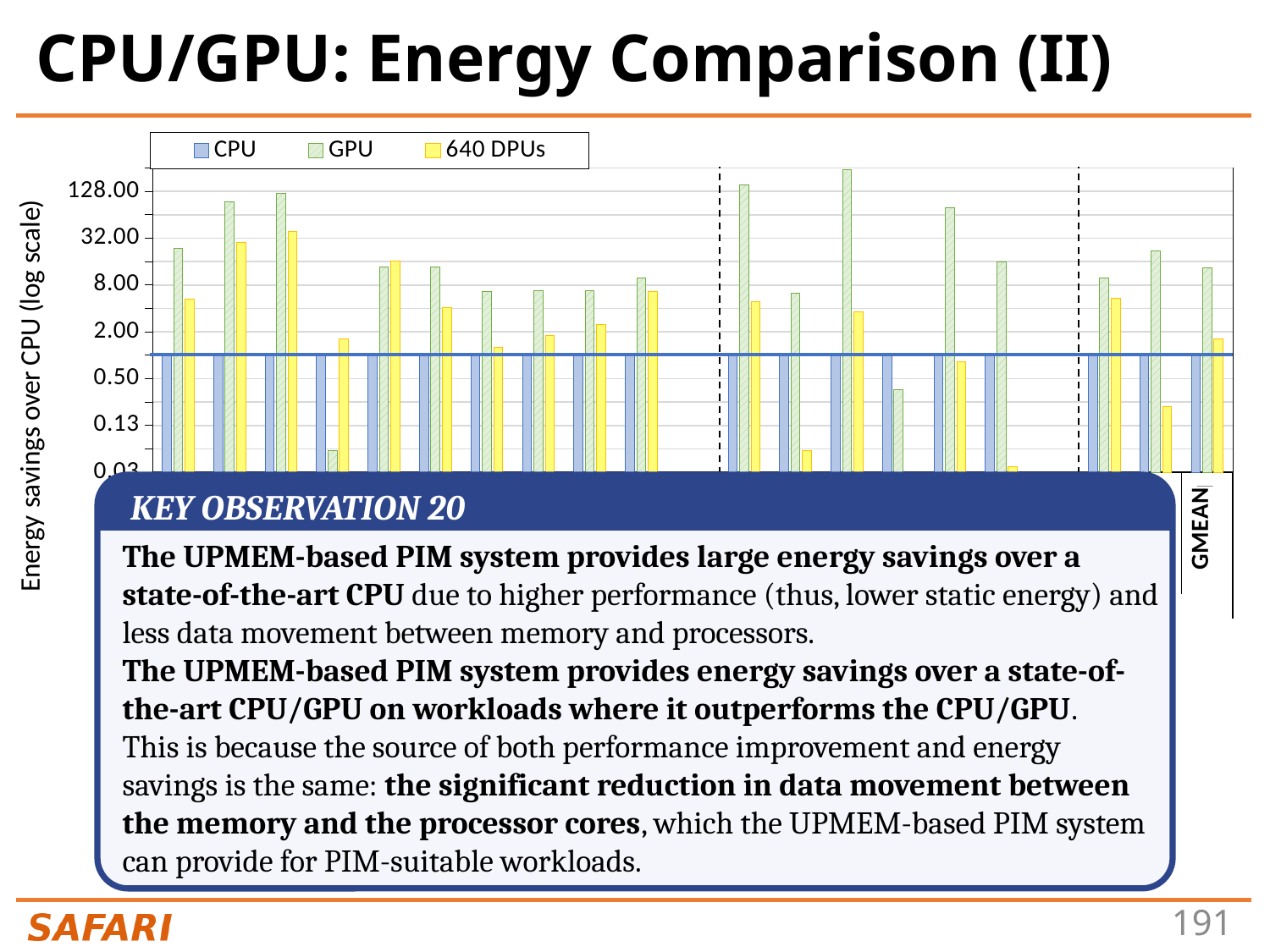
For the GMEAN category, which series has the larger value, GPU or 640 DPUs? GPU What are the three series named in the chart legend? CPU, GPU, 640 DPUs For the GMEAN category, is the CPU value greater or less than 2.00? less For the GMEAN category, is the 640 DPUs value greater or less than 0.50? greater How many series does the chart legend list? 3 What kind of chart is shown on the slide? bar chart For the GMEAN category, is the GPU value greater or less than 8.00? greater What is the label of the chart's y axis? Energy savings over CPU (log scale) For the GMEAN category, which series has the smallest value? CPU